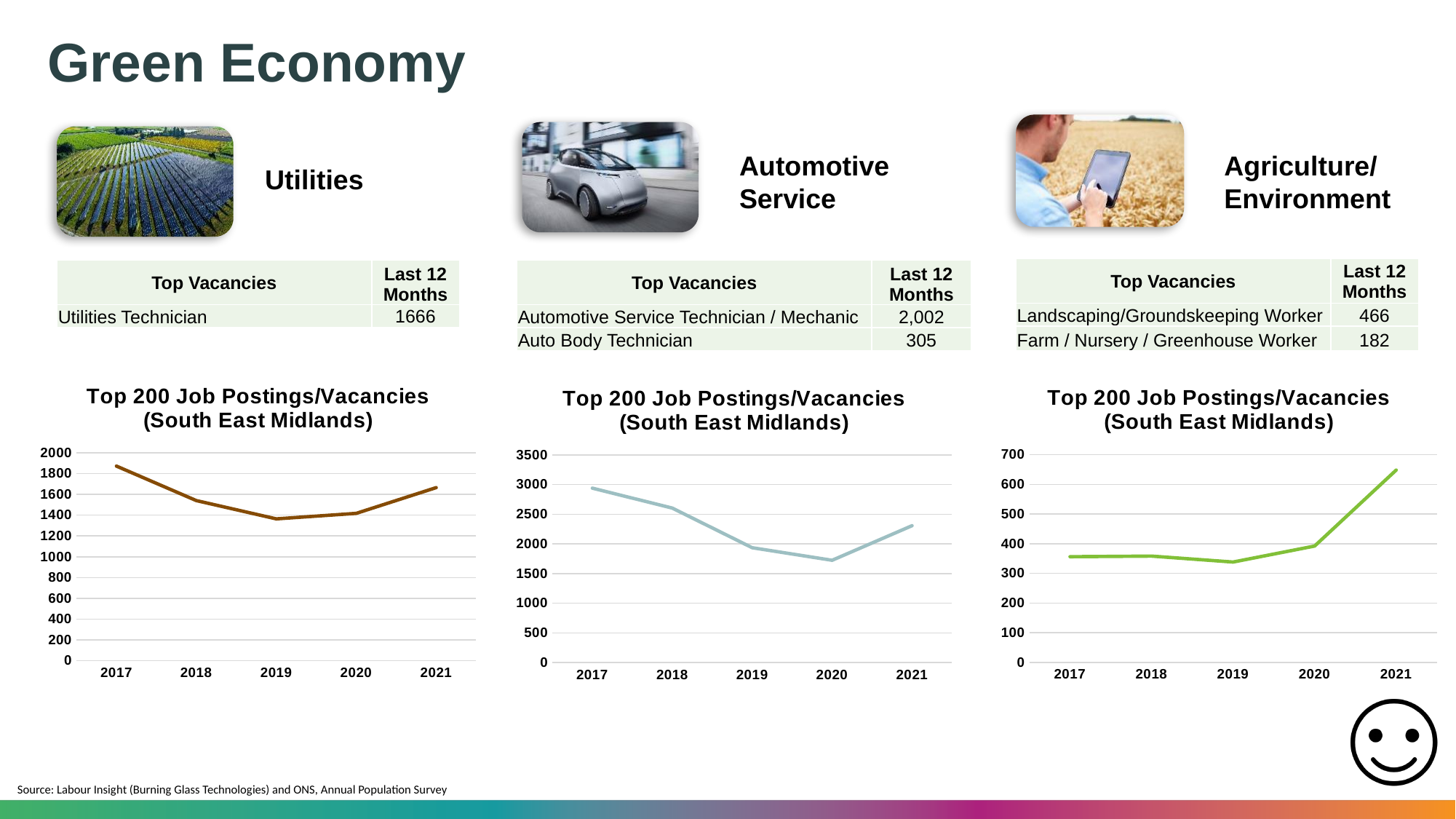
In the middle chart (Automotive Service), which year has the lowest value? 2020 In the middle chart (Automotive Service), which year has the highest value? 2017 In the right chart (Agriculture/Environment), which year has the highest value? 2021 In the left chart (Utilities), is the value for 2017 greater or less than 1800? greater In the middle chart (Automotive Service), is the value for 2021 greater or less than 2000? greater In the left chart (Utilities), how many years are plotted on the x axis? 5 In the left chart (Utilities), which year has the lowest value? 2019 In the right chart (Agriculture/Environment), is the value for 2021 greater or less than 600? greater What kind of chart is the left chart under Utilities? line chart In the left chart (Utilities), which year has the highest value? 2017 In the right chart (Agriculture/Environment), do the values rise or fall between 2020 and 2021? rise